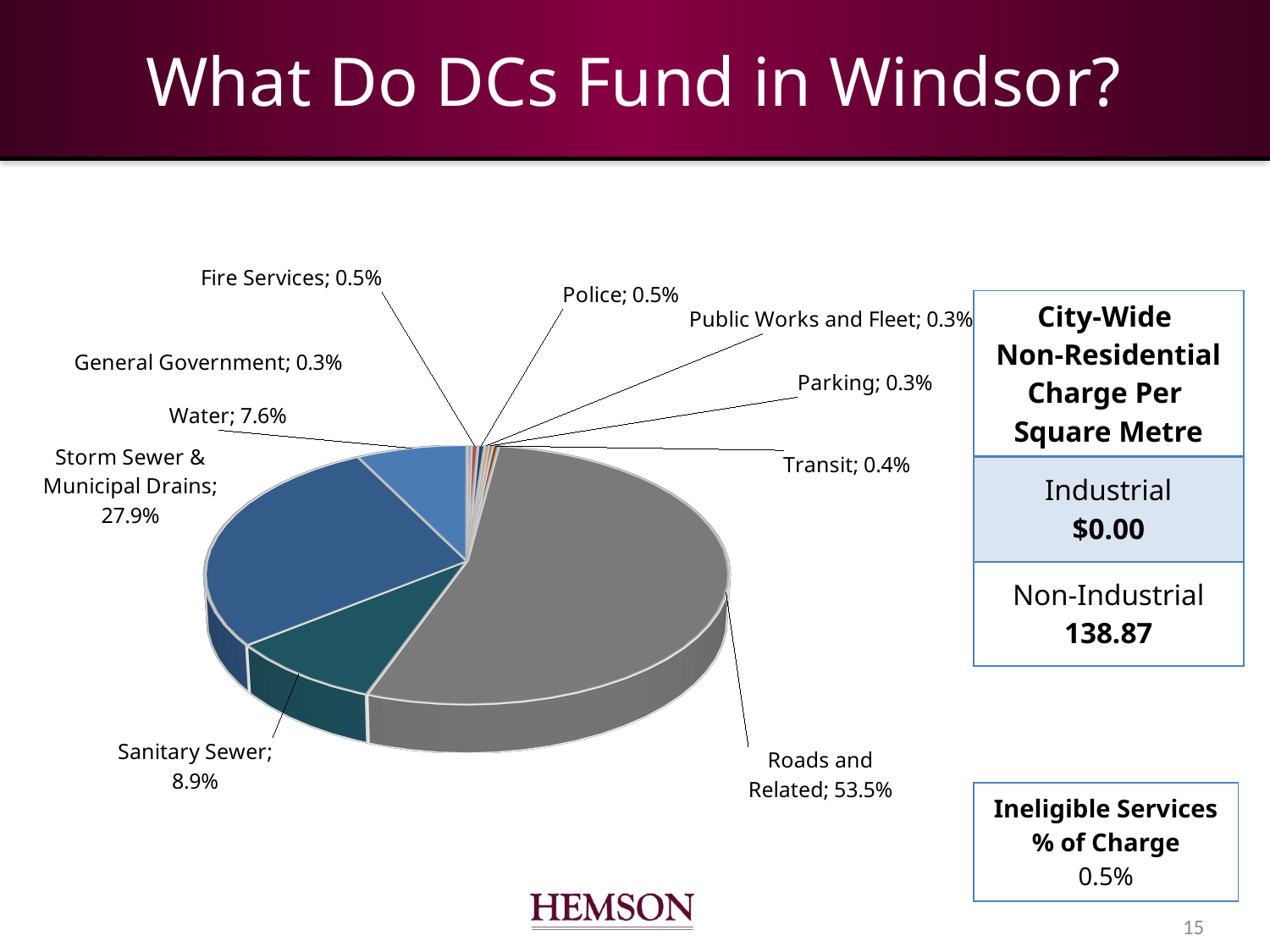
What is the value shown for Sanitary Sewer? 8.9% Which category has the largest slice of the pie? Roads and Related What is the value shown for Transit? 0.4% How many categories are shown in the pie chart? 10 What is the difference between the shares for Storm Sewer & Municipal Drains and Sanitary Sewer? 19.0% Which is larger, the share for Water or the share for Sanitary Sewer? Sanitary Sewer What is the value shown for Water? 7.6% What share of the pie does Roads and Related account for? 53.5% What is the title of the slide containing the pie chart? What Do DCs Fund in Windsor? What kind of chart is shown on the slide? Pie chart What is the combined share of Fire Services and Police? 1.0% What is the value shown for Storm Sewer & Municipal Drains? 27.9%